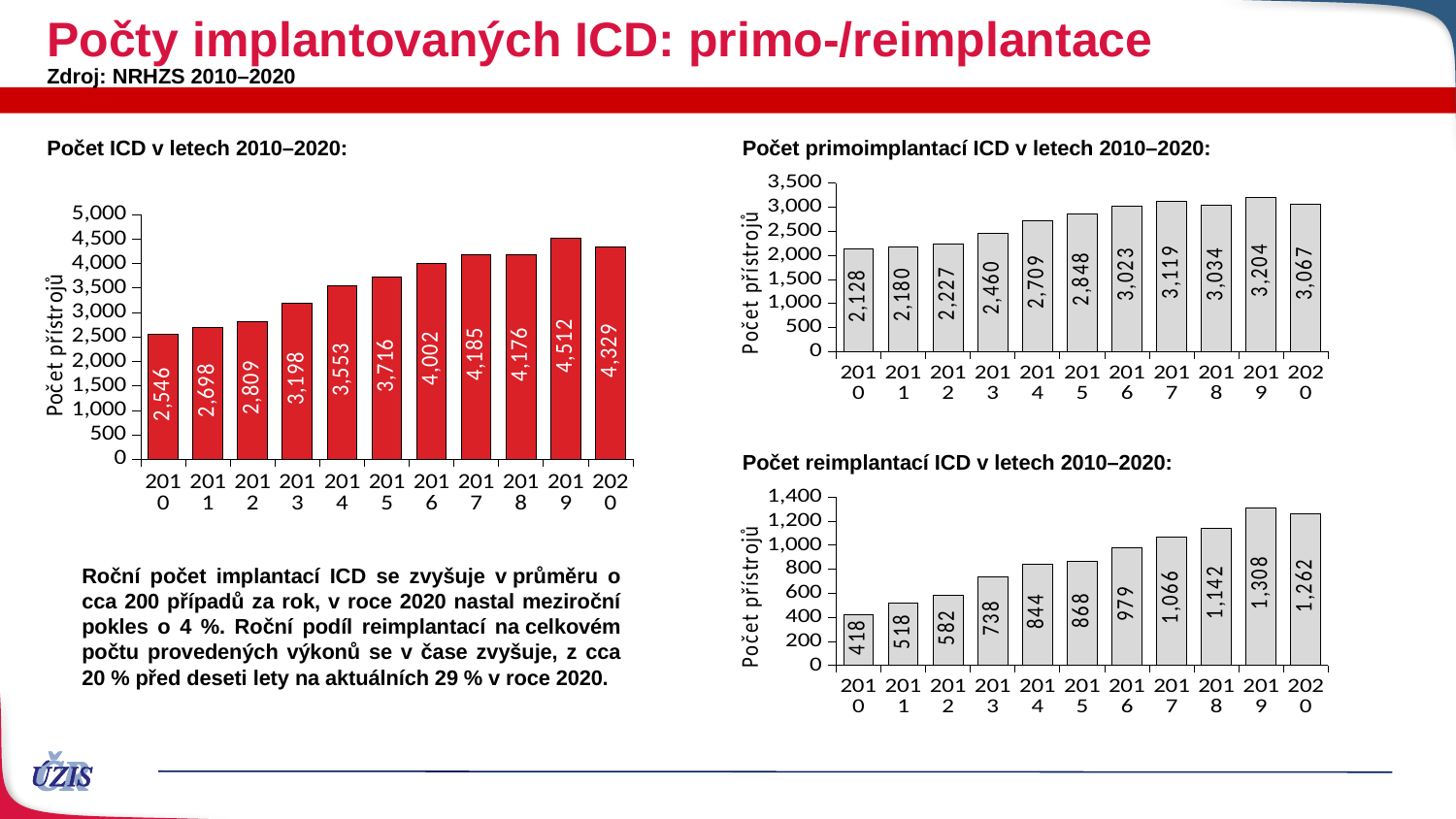
In the chart 'Počet reimplantací ICD v letech 2010–2020', what is the difference between the values for 2010 and 2020? 844 In the chart 'Počet ICD v letech 2010–2020', which year has the lowest value? 2010 In the chart 'Počet reimplantací ICD v letech 2010–2020', is the value for 2016 greater or less than 1,000? less In the chart 'Počet primoimplantací ICD v letech 2010–2020', what is the value for 2016? 3,023 In the chart 'Počet ICD v letech 2010–2020', how many years are plotted? 11 In the chart 'Počet reimplantací ICD v letech 2010–2020', do the values generally rise or fall from 2010 to 2019? Rise In the chart 'Počet ICD v letech 2010–2020', what is the difference between the values for 2019 and 2020? 183 In the chart 'Počet primoimplantací ICD v letech 2010–2020', which year has the highest value? 2019 In the chart 'Počet reimplantací ICD v letech 2010–2020', what is the value for 2013? 738 In the chart 'Počet primoimplantací ICD v letech 2010–2020', is the value for 2017 larger than the value for 2018? Yes What kind of chart is 'Počet reimplantací ICD v letech 2010–2020'? Bar chart In the chart 'Počet ICD v letech 2010–2020', what is the value for 2019? 4,512